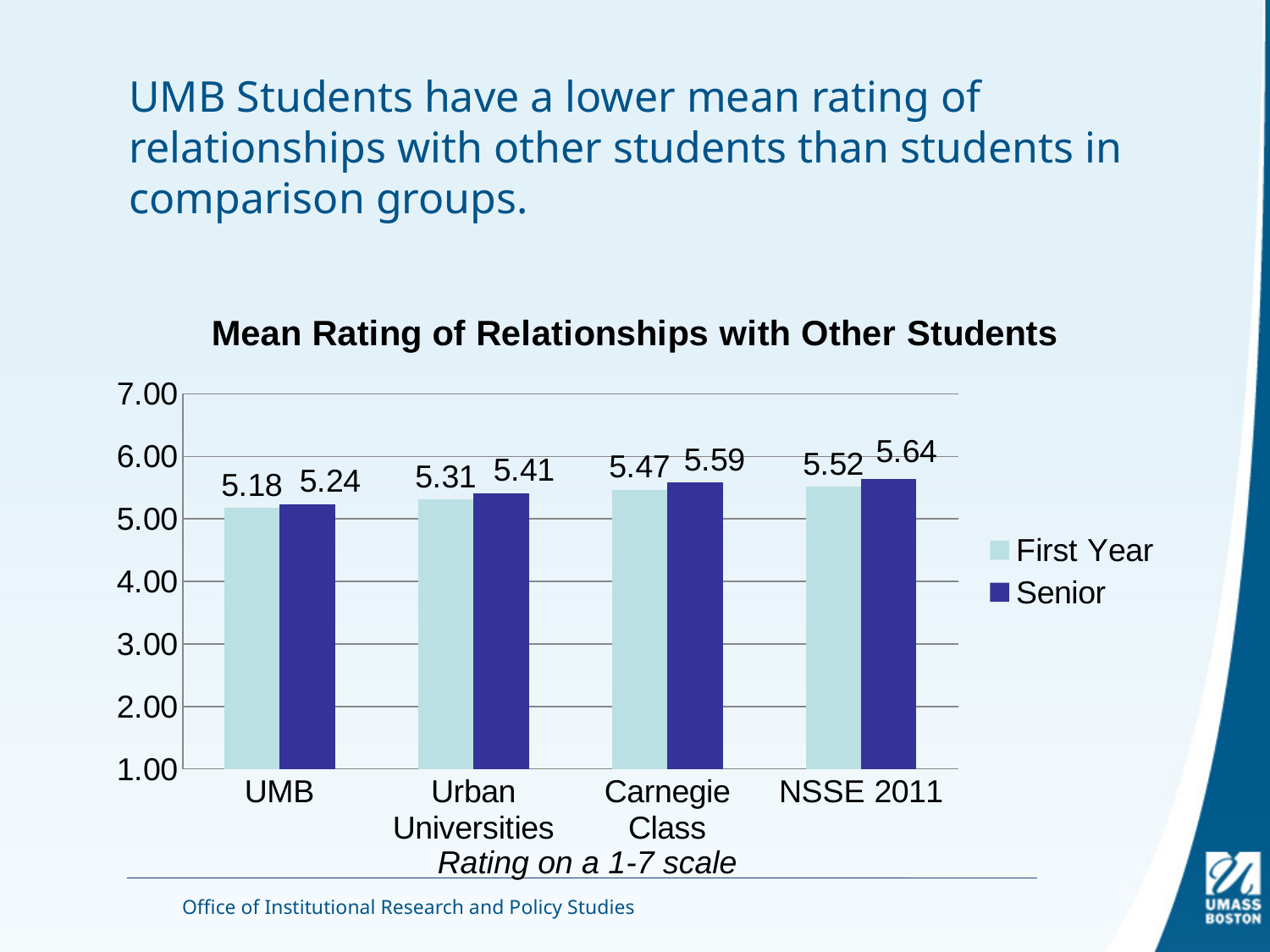
How many categories are shown on the x axis? 4 Which is larger, the Senior rating for UMB or the First Year rating for Urban Universities? First Year rating for Urban Universities What is the difference between the Senior and First Year ratings for Carnegie Class? 0.12 What is the Senior mean rating for Urban Universities? 5.41 Which category has the highest Senior rating? NSSE 2011 What is the Senior mean rating for NSSE 2011? 5.64 Which category has the lowest First Year rating? UMB What is the title of the chart? Mean Rating of Relationships with Other Students What is the First Year mean rating for UMB? 5.18 What kind of chart is shown? Bar chart What is the difference between the NSSE 2011 and UMB First Year ratings? 0.34 How many series does the legend list? 2